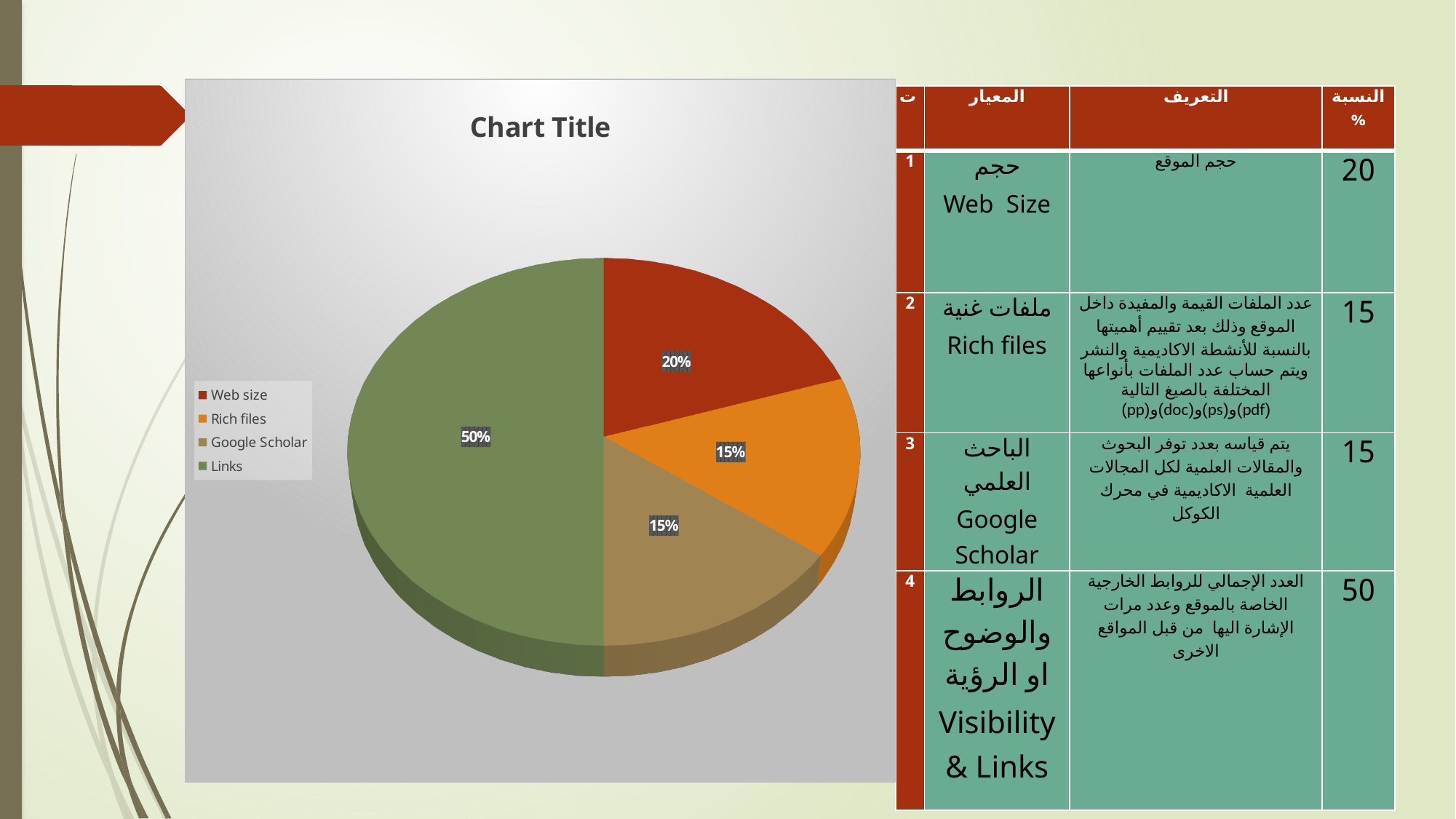
What percentage of the pie does the Links slice represent? 50% How many entries does the chart legend list? 4 What type of chart is shown on the slide? pie chart What is the title of the chart? Chart Title How many slices does the pie chart have? 4 What percentage of the pie does the Rich files slice represent? 15% What percentage of the pie does the Web size slice represent? 20% Which category has the largest slice of the pie? Links What percentage of the pie does the Google Scholar slice represent? 15% What colour is the Links slice in the pie chart? green What is the difference in percentage points between the Links slice and the Web size slice? 30 Which slice is larger, Web size or Rich files? Web size